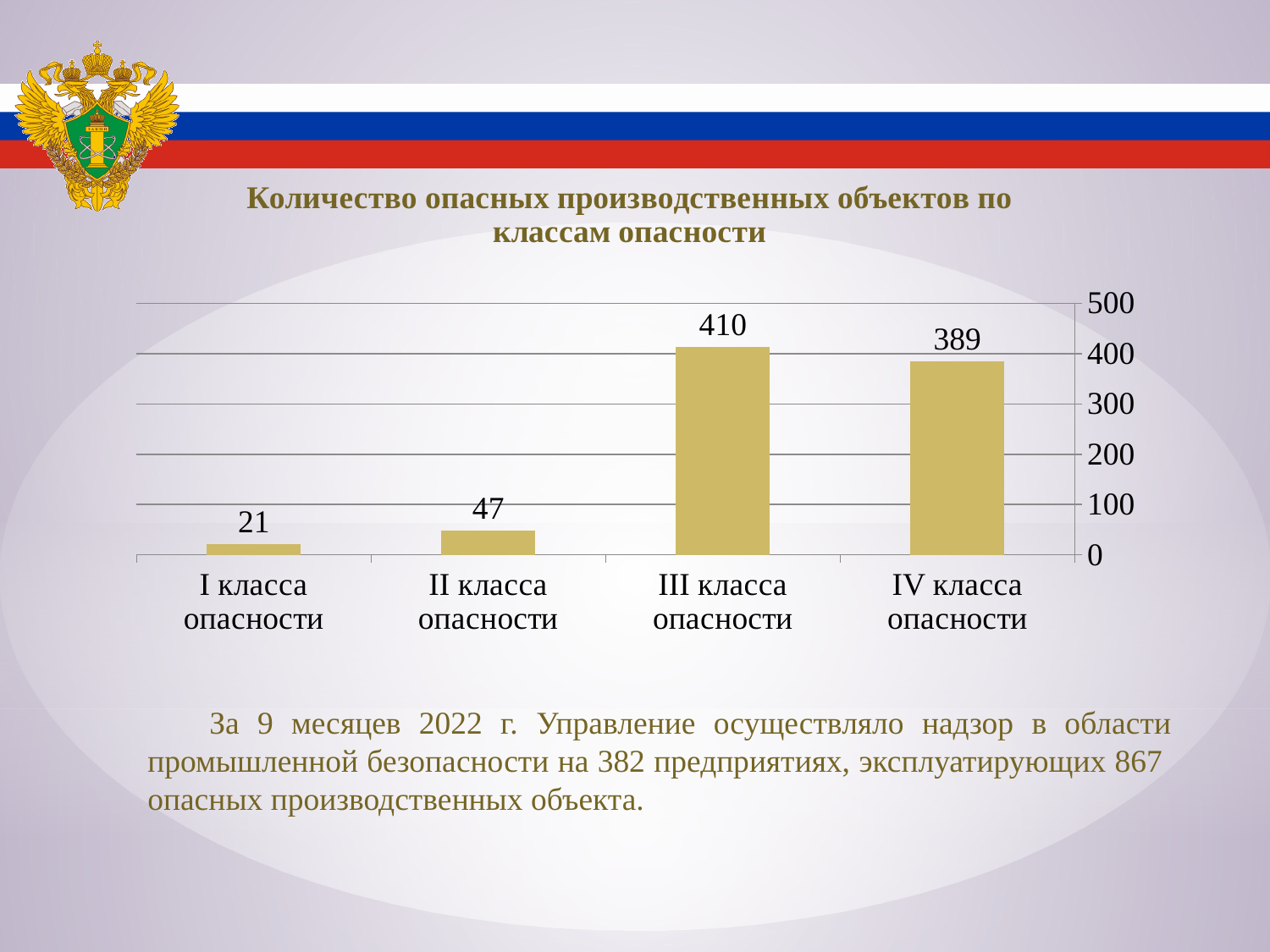
What is the value for IV класса опасности? 389 What is the value for III класса опасности? 410 What kind of chart is shown on the slide? bar chart Which hazard class has the highest number of objects? III класса опасности What is the value for I класса опасности? 21 What is the difference between the values for III класса опасности and IV класса опасности? 21 What is the value for II класса опасности? 47 Is the value for IV класса опасности greater or less than 300? greater Which hazard class has the lowest number of objects? I класса опасности How many categories are shown on the chart? 4 What is the difference between the values for II класса опасности and I класса опасности? 26 Which is larger, the value for II класса опасности or the value for I класса опасности? II класса опасности